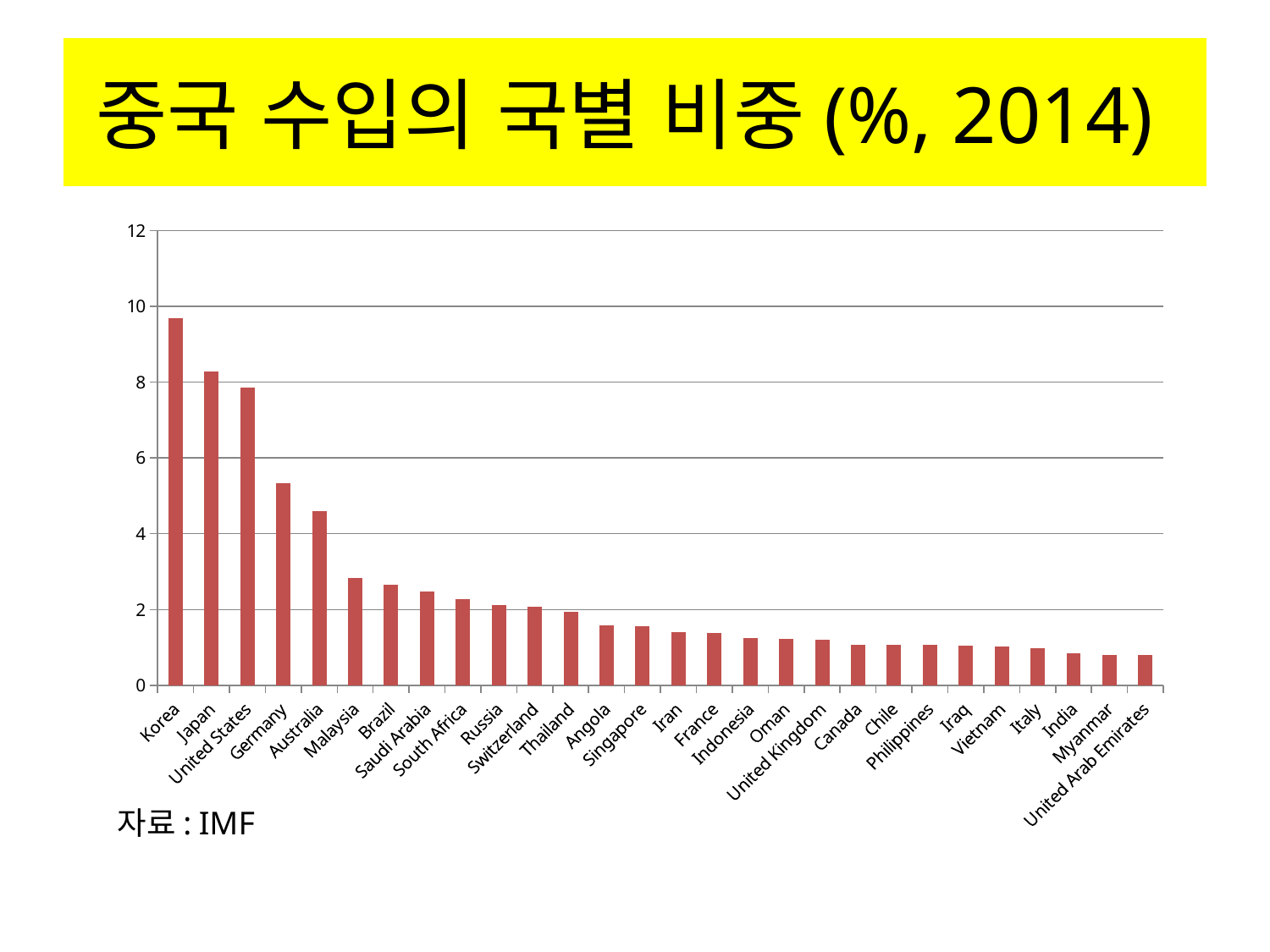
Which country has the highest share of China's imports in the chart? Korea Is the value for Canada greater or less than 2? less What kind of chart is shown on the slide? bar chart Is the value for Germany greater or less than 4? greater Which has a larger value, Germany or Australia? Germany How many countries are shown on the x axis of the chart? 28 Do the values rise or fall moving from left to right along the x axis? fall Is the value for Angola greater or less than 2? less What source is cited below the chart? IMF Which has a larger value, Korea or Japan? Korea